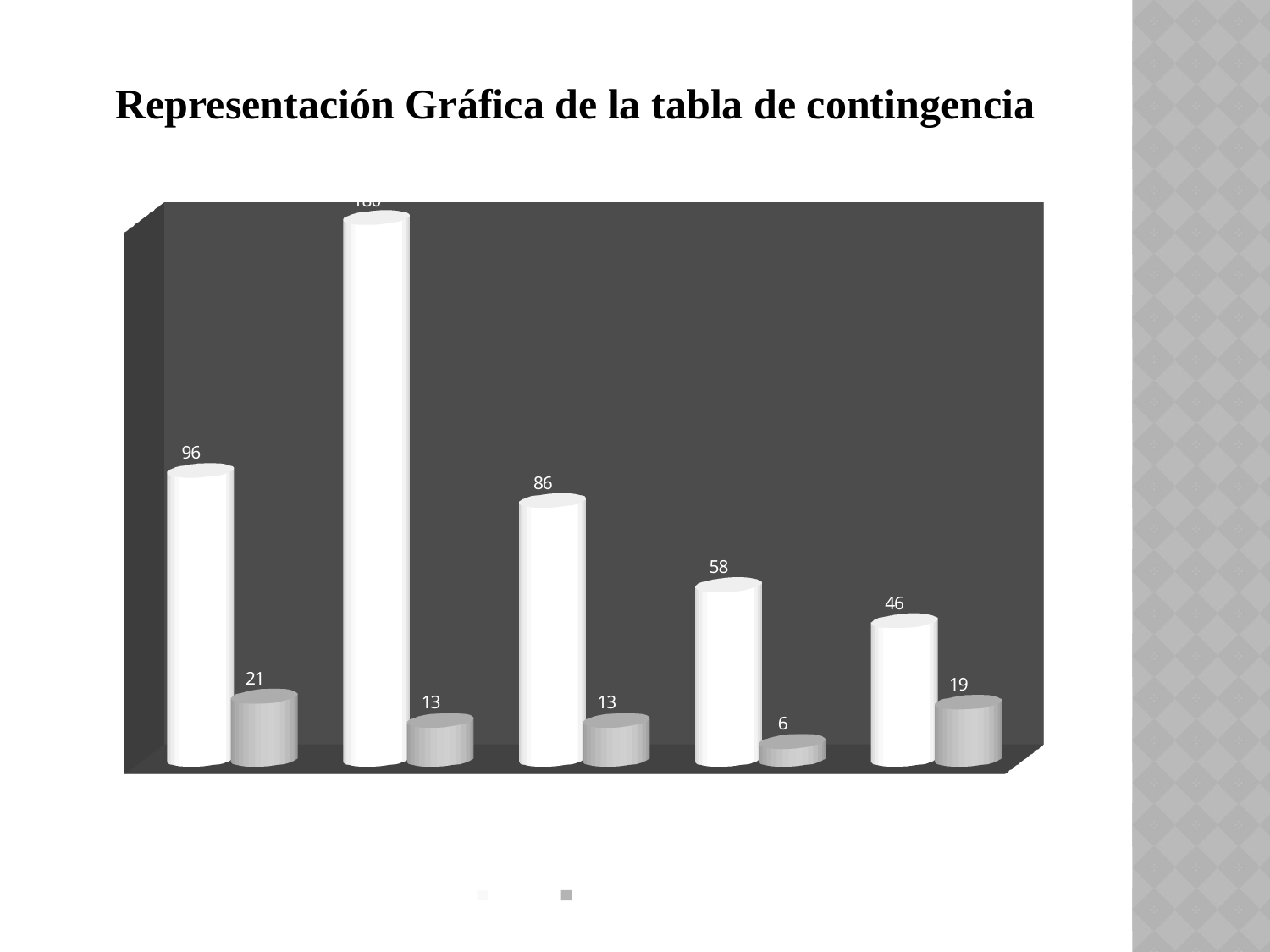
What is the difference between the white bar and the grey bar in the first (leftmost) group? 75 What kind of chart is shown on the slide? bar chart What is the value of the white bar in the fifth (rightmost) group? 46 What is the value of the white bar in the third group from the left? 86 Which group from the left has the lowest grey bar? the fourth group How many series does the chart's legend list? 2 What is the value of the grey bar in the fourth group from the left? 6 What is the value of the grey bar in the first (leftmost) group? 21 What is the title of the chart on the slide? Representación Gráfica de la tabla de contingencia How many category groups are plotted in the chart? 5 Which group from the left has the tallest white bar? the second group What is the value of the white bar in the first (leftmost) group? 96